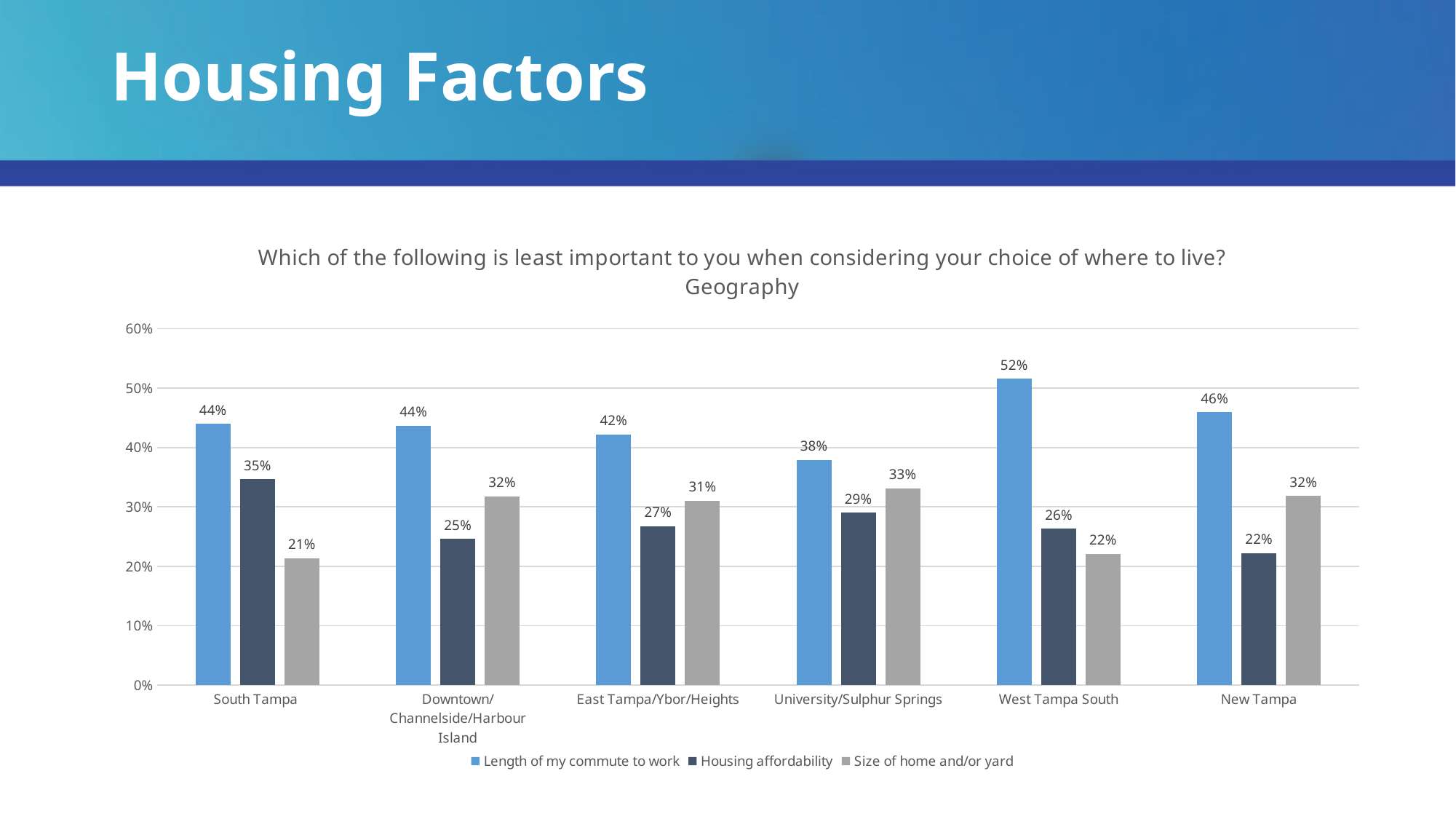
Is the value for 'Length of my commute to work' in University/Sulphur Springs greater or less than 40%? less What is the value for 'Housing affordability' in South Tampa? 35% What is the difference between 'Length of my commute to work' and 'Housing affordability' in New Tampa? 24% Which geography has the lowest value for 'Size of home and/or yard'? South Tampa How many series does the legend list? 3 What kind of chart is shown on the slide? Bar chart Which geography has the highest value for 'Length of my commute to work'? West Tampa South Which series is shown in light blue? Length of my commute to work How many geographies are shown on the x axis? 6 What is the value for 'Size of home and/or yard' in University/Sulphur Springs? 33% What is the value for 'Length of my commute to work' in West Tampa South? 52% Which is larger in East Tampa/Ybor/Heights: 'Housing affordability' or 'Size of home and/or yard'? Size of home and/or yard